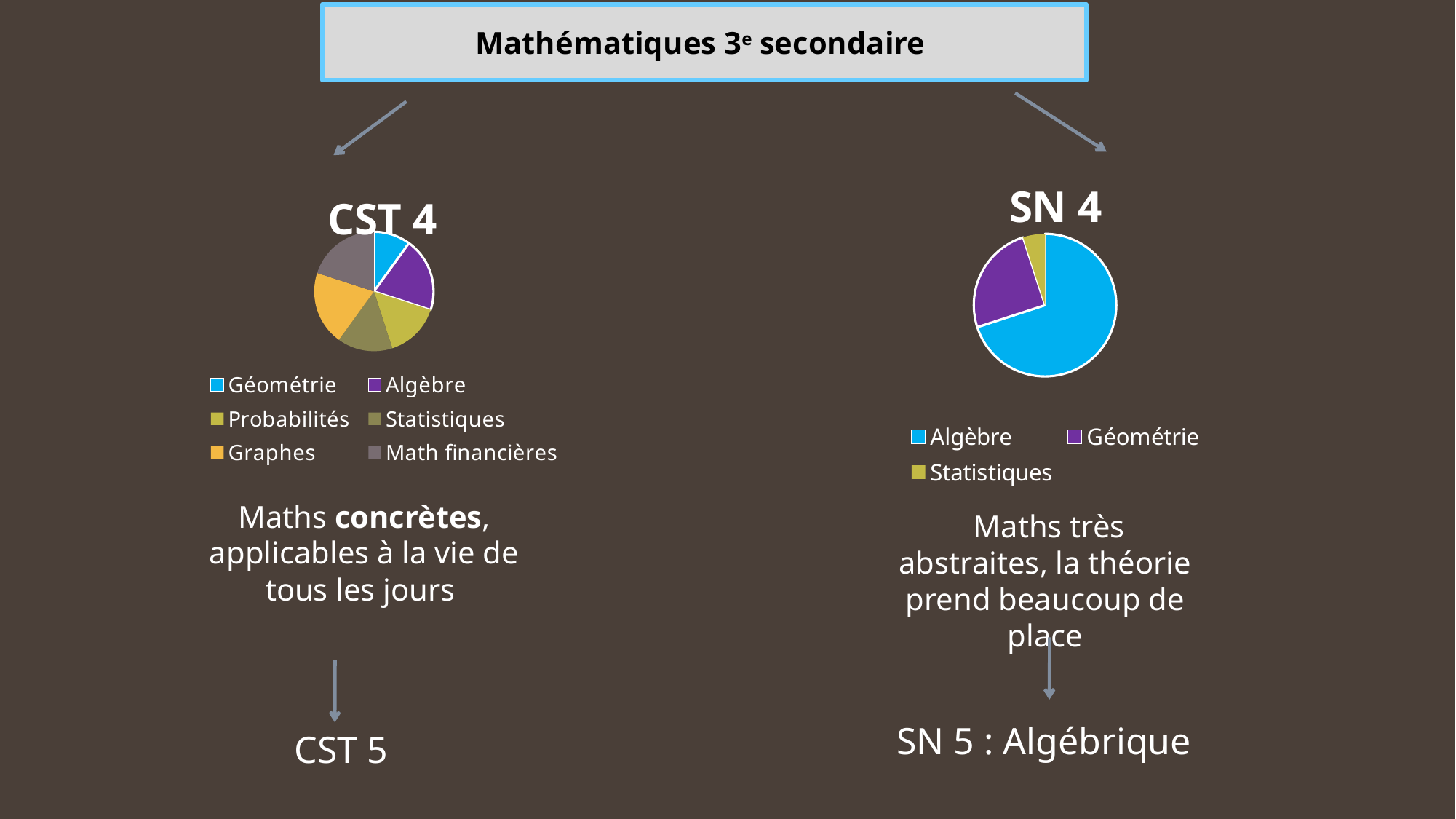
In the CST 4 pie chart, which category has the smallest slice? Géométrie In the SN 4 pie chart, which category has the smallest slice? Statistiques In the SN 4 pie chart, which slice is larger, Algèbre or Géométrie? Algèbre In the SN 4 pie chart, which slice is larger, Géométrie or Statistiques? Géométrie What kind of chart is the SN 4 chart? pie chart What kind of chart is the CST 4 chart? pie chart In the CST 4 pie chart, what colour is the Graphes slice? orange How many categories does the CST 4 pie chart show? 6 In the CST 4 pie chart, which slice is larger, Géométrie or Graphes? Graphes How many categories does the SN 4 pie chart show? 3 In the SN 4 pie chart, which category has the largest slice? Algèbre In the SN 4 pie chart, what colour is the Algèbre slice? blue